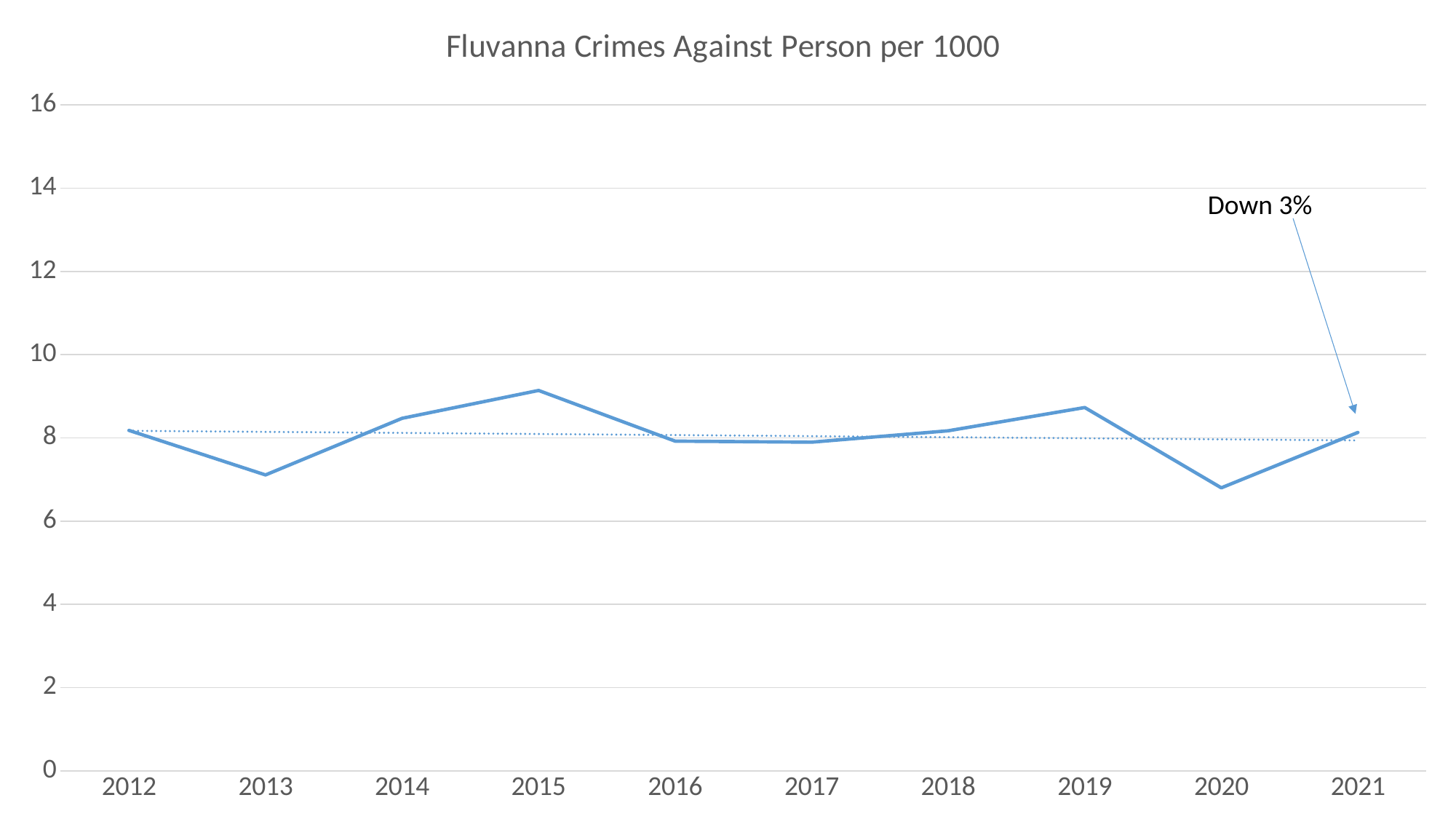
Is the value for 2015 greater or less than 8? greater What is the title of the chart? Fluvanna Crimes Against Person per 1000 What kind of chart is shown on the slide? line chart What does the annotation with the arrow pointing to 2021 say? Down 3% Is the value for 2020 greater or less than 8? less Which year has a higher value, 2019 or 2013? 2019 Which year has the highest crimes against person rate? 2015 Is the value for 2013 greater or less than 8? less Which year has a higher value, 2015 or 2020? 2015 How many years are plotted along the x axis? 10 Which year has the lowest crimes against person rate? 2020